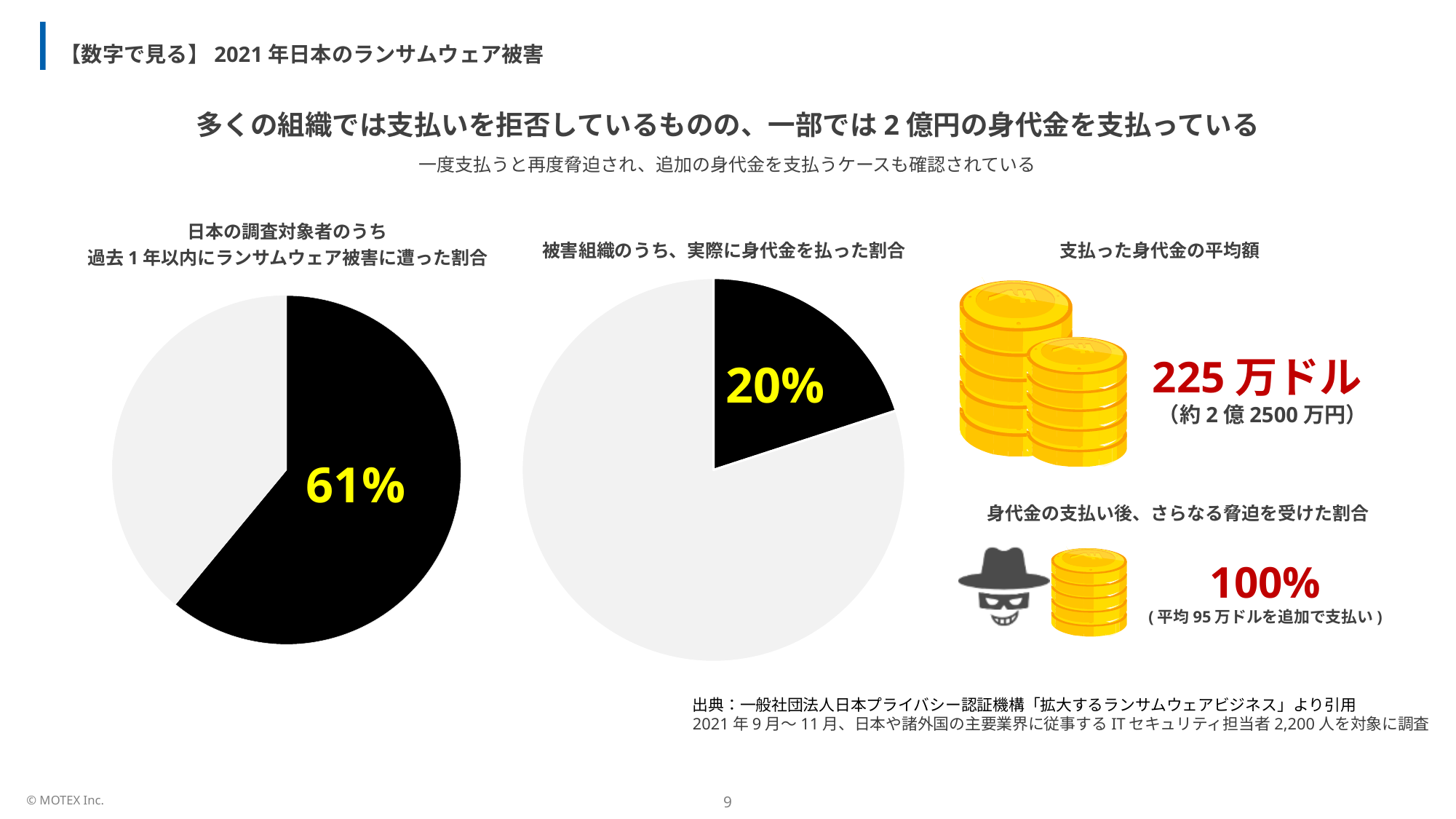
In the middle pie chart, what share does the unlabelled grey slice represent, given the black slice is 20%? 80% What kind of chart is used for 「日本の調査対象者のうち過去1年以内にランサムウェア被害に遭った割合」? Pie chart How many slices does the left pie chart (日本の調査対象者のうち過去1年以内にランサムウェア被害に遭った割合) have? 2 What kind of chart is used for 「被害組織のうち、実際に身代金を払った割合」? Pie chart What is the difference between the labelled share in the left pie chart and the labelled share in the middle pie chart? 41 percentage points Which is larger: the labelled share in the left pie chart (61%) or the labelled share in the middle pie chart (20%)? The left pie chart (61%) In the left pie chart (日本の調査対象者のうち過去1年以内にランサムウェア被害に遭った割合), what share is shown for the black slice? 61% In the middle pie chart, is the black slice's share greater or less than 50%? less What colour is the slice that carries the percentage label in both pie charts? Black How many slices does the middle pie chart (被害組織のうち、実際に身代金を払った割合) have? 2 In the left pie chart, is the black slice's share greater or less than 50%? greater In the middle pie chart (被害組織のうち、実際に身代金を払った割合), what share is shown for the black slice? 20%